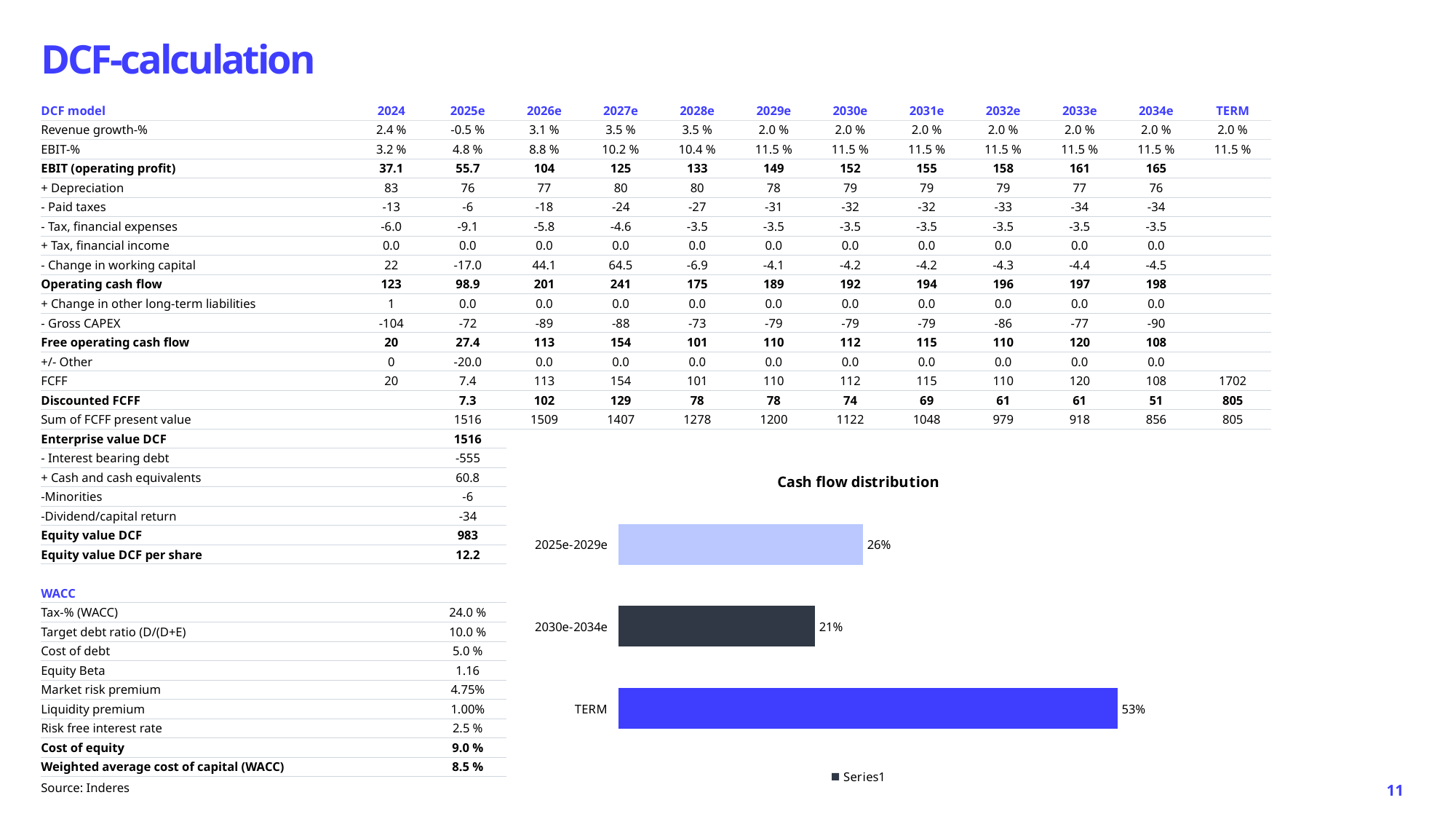
What kind of chart is the Cash flow distribution chart? Bar chart How many categories are shown in the Cash flow distribution chart? 3 Which category has the highest value in the Cash flow distribution chart? TERM What is the value for 2025e-2029e in the Cash flow distribution chart? 26% What is the difference between the 2025e-2029e value and the 2030e-2034e value in the Cash flow distribution chart? 5% What is the difference between the TERM value and the 2025e-2029e value in the Cash flow distribution chart? 27% In the Cash flow distribution chart, which is larger: the value for 2025e-2029e or the value for 2030e-2034e? 2025e-2029e What is the title of the chart on the slide? Cash flow distribution How many series does the legend of the Cash flow distribution chart list? 1 Which category has the lowest value in the Cash flow distribution chart? 2030e-2034e What is the value for TERM in the Cash flow distribution chart? 53% What is the value for 2030e-2034e in the Cash flow distribution chart? 21%